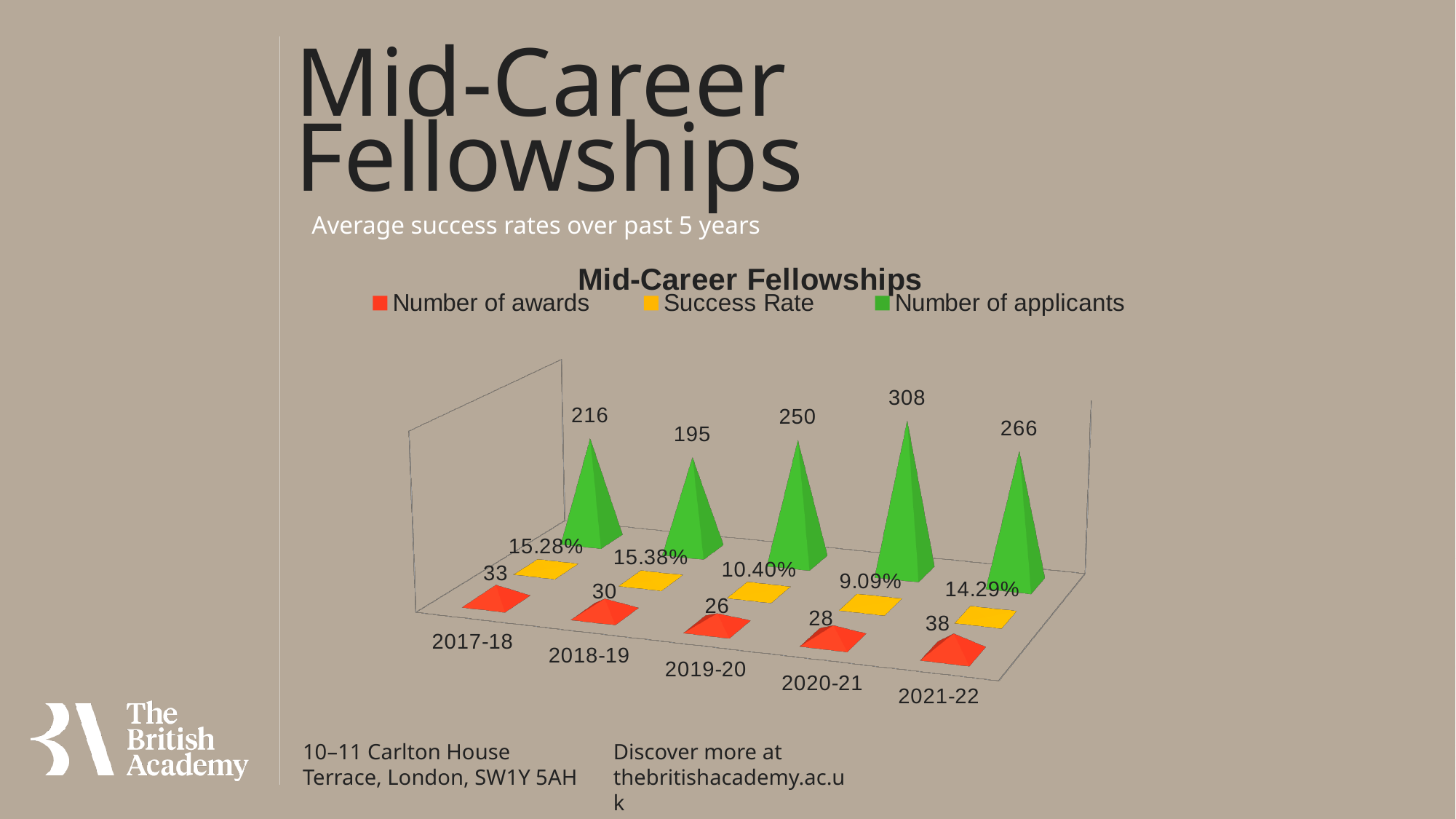
What is the Success Rate for 2019-20? 10.40% What is the difference in Number of applicants between 2020-21 and 2018-19? 113 What is the title of the chart? Mid-Career Fellowships Which is larger, the Number of applicants in 2019-20 or in 2021-22? 2021-22 What is the difference in Number of awards between 2021-22 and 2017-18? 5 How many years are shown on the x axis? 5 Which year has the lowest Success Rate? 2020-21 Which year has the lowest Number of awards? 2019-20 Which year has the highest Number of applicants? 2020-21 What is the Number of awards for 2021-22? 38 What is the Number of applicants for 2020-21? 308 How many series does the legend list? 3